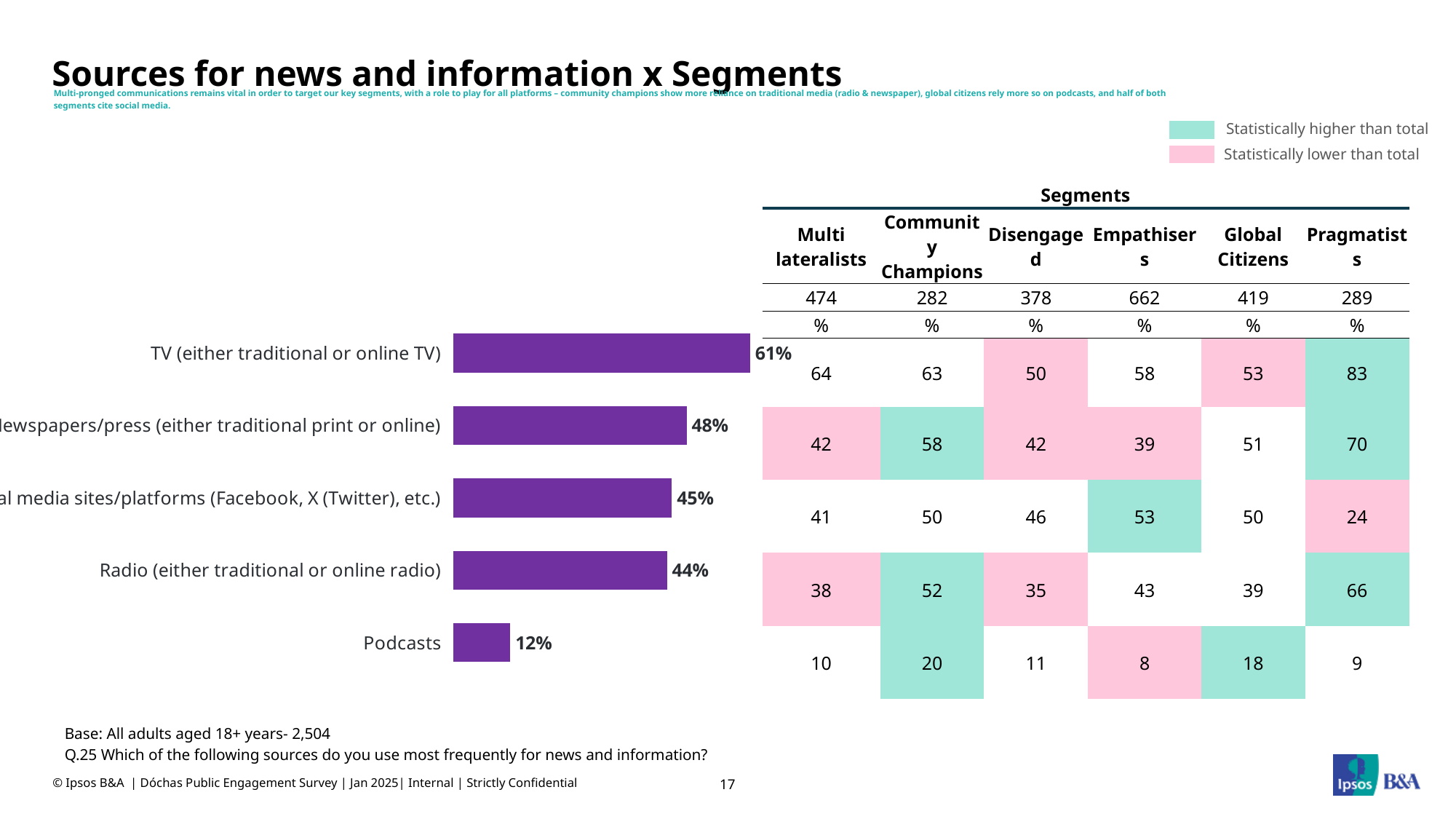
What percentage is shown for TV (either traditional or online TV) in the bar chart? 61% Which source has the lowest percentage in the bar chart? Podcasts What type of chart is used to show the sources for news and information? Bar chart Which source has the highest percentage in the bar chart? TV (either traditional or online TV) What is the difference in percentage points between TV and Podcasts in the bar chart? 49 Which has a higher percentage in the bar chart, Social media sites/platforms or Radio? Social media sites/platforms What percentage is shown for Podcasts in the bar chart? 12% How many sources are shown as bars in the bar chart? 5 What percentage is shown for Newspapers/press (either traditional print or online) in the bar chart? 48% What percentage is shown for Radio (either traditional or online radio) in the bar chart? 44% What colour are the bars in the bar chart? Purple What is the difference in percentage points between Newspapers/press and Radio in the bar chart? 4